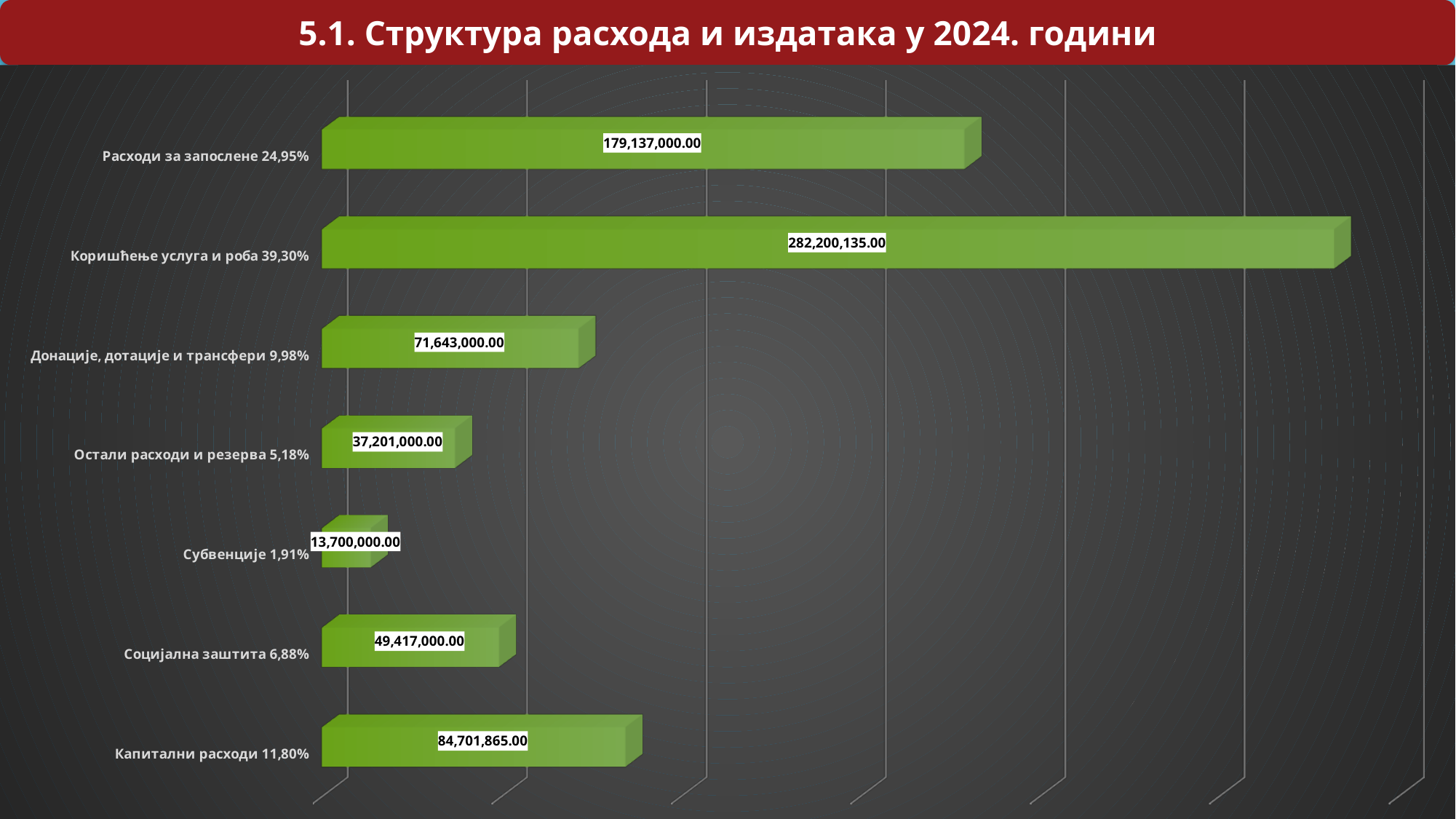
What is the value shown for Расходи за запослене? 179,137,000.00 What is the value shown for Субвенције? 13,700,000.00 Which category has the highest value? Коришћење услуга и роба What is the difference between the values for Коришћење услуга и роба and Расходи за запослене? 103,063,135.00 What is the value shown for Капитални расходи? 84,701,865.00 What is the value shown for Коришћење услуга и роба? 282,200,135.00 Which is larger, the value for Социјална заштита or the value for Остали расходи и резерва? Социјална заштита What percentage share is shown in the label for Донације, дотације и трансфери? 9,98% What is the difference between the values for Капитални расходи and Донације, дотације и трансфери? 13,058,865.00 Which category has the lowest value? Субвенције How many categories are shown in the chart? 7 What kind of chart is shown on the slide? Bar chart